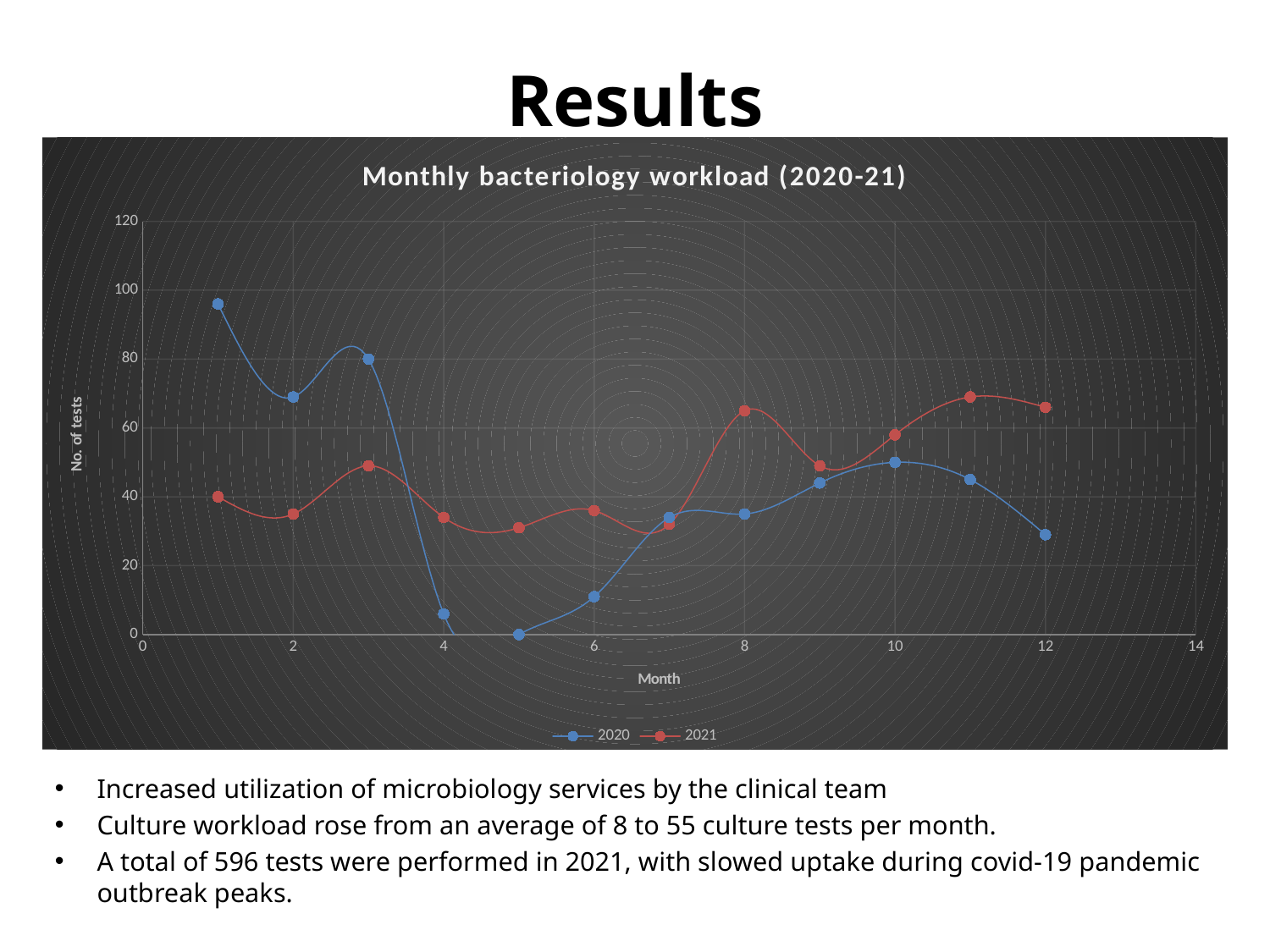
Is the value for the 2020 series in month 1 greater or less than 80? greater How many series does the legend list? 2 In month 1, which series has the larger value, 2020 or 2021? 2020 In which month does the 2020 series reach its highest value? Month 1 Does the 2020 series rise or fall from month 1 to month 5? fall What is the label on the vertical axis? No. of tests In month 12, which series has the larger value, 2020 or 2021? 2021 Is the value for the 2021 series in month 8 greater or less than 60? greater What kind of chart is shown on the slide? line chart Is the value for the 2020 series in month 4 greater or less than 20? less What is the title of the chart? Monthly bacteriology workload (2020-21) How many monthly data points are plotted for the 2021 series? 12